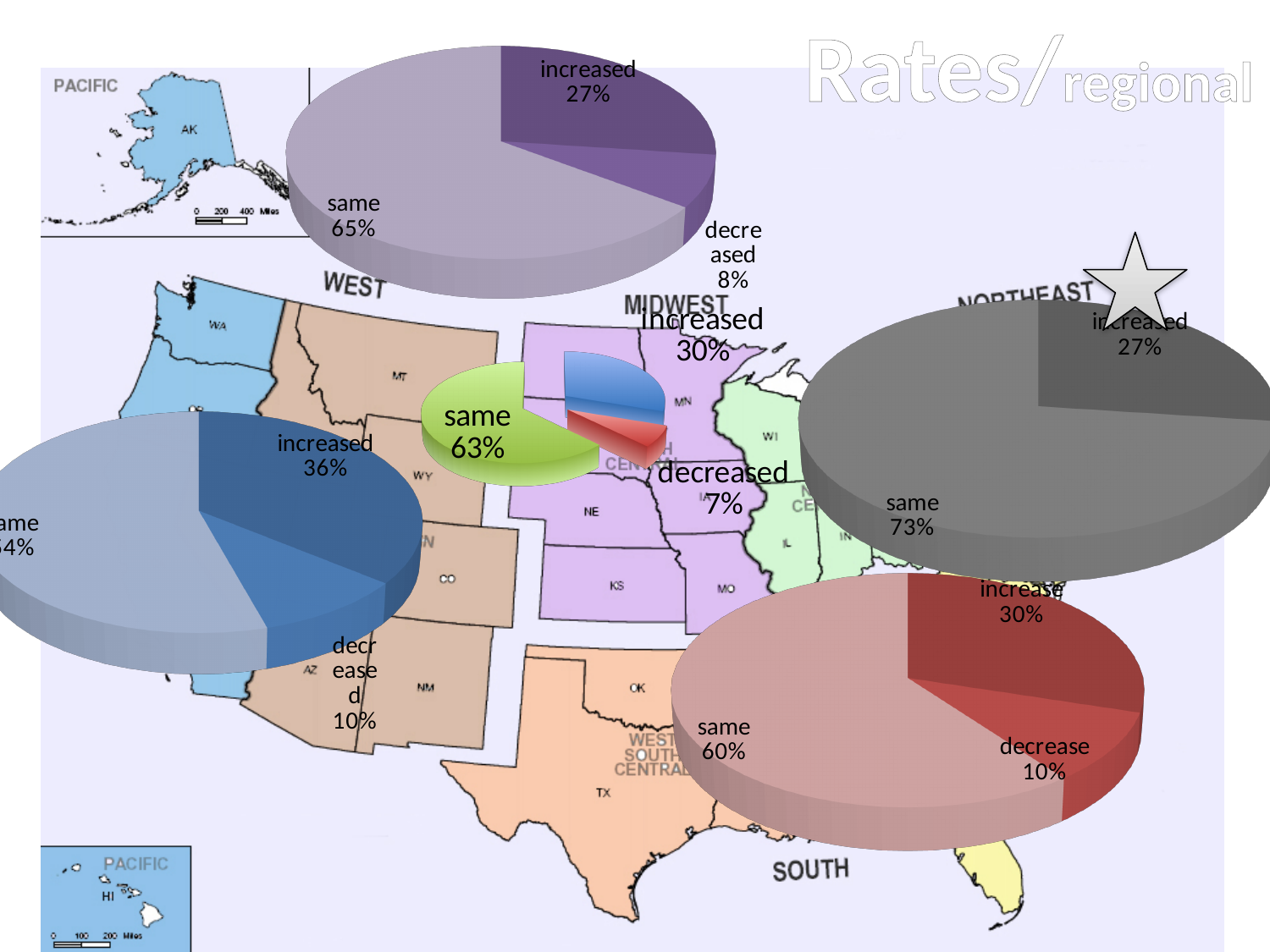
In the red pie chart at the bottom right of the slide, what share is labelled 'decrease'? 10% In the small green pie chart in the centre of the slide, which slice is the smallest? decreased Which is larger: the 'same' share in the grey pie chart on the right or the 'same' share in the red pie chart at the bottom right? the grey pie chart on the right (73%) In the purple pie chart at the top of the slide, which slice is the largest? same In the blue pie chart on the left of the slide, what is the difference between the 'increased' and 'decreased' shares? 26% What kind of charts are shown on the slide? pie charts In the grey pie chart on the right of the slide, what share is labelled 'same'? 73% In the blue pie chart on the left of the slide, what share is labelled 'increased'? 36% In the purple pie chart at the top of the slide, what share is labelled 'decreased'? 8% How many pie charts are on the slide? 5 In the small green pie chart in the centre of the slide, what share is labelled 'same'? 63% In the purple pie chart at the top of the slide, what share is labelled 'same'? 65%